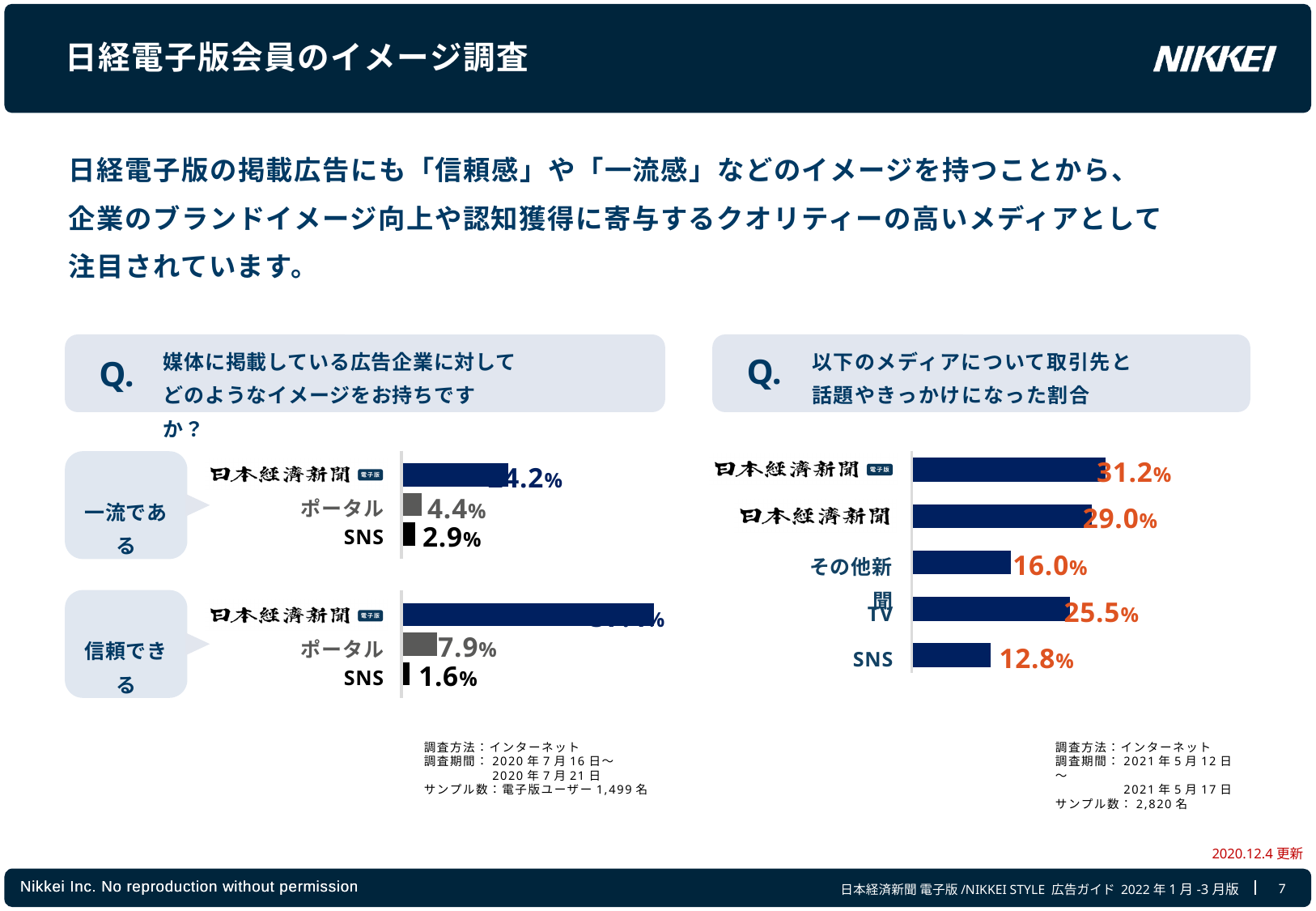
In the left chart for 信頼できる, what is the difference between ポータル and SNS? 6.3% In the right chart (以下のメディアについて取引先と話題やきっかけになった割合), what is the value for 日本経済新聞 電子版? 31.2% In the right chart (以下のメディアについて取引先と話題やきっかけになった割合), what is the value for SNS? 12.8% In the right chart (以下のメディアについて取引先と話題やきっかけになった割合), how many media categories are shown? 5 What type of chart is used on the right side of the slide? Bar chart In the left chart for 信頼できる, what is the value for SNS? 1.6% In the right chart (以下のメディアについて取引先と話題やきっかけになった割合), which media has the highest value? 日本経済新聞 電子版 In the left chart for 一流である, what is the value for ポータル? 4.4% In the right chart (以下のメディアについて取引先と話題やきっかけになった割合), what is the difference between 日本経済新聞 電子版 and 日本経済新聞? 2.2% In the right chart (以下のメディアについて取引先と話題やきっかけになった割合), which is larger, TV or その他新聞? TV In the right chart (以下のメディアについて取引先と話題やきっかけになった割合), which media has the lowest value? SNS In the right chart (以下のメディアについて取引先と話題やきっかけになった割合), what is the value for TV? 25.5%